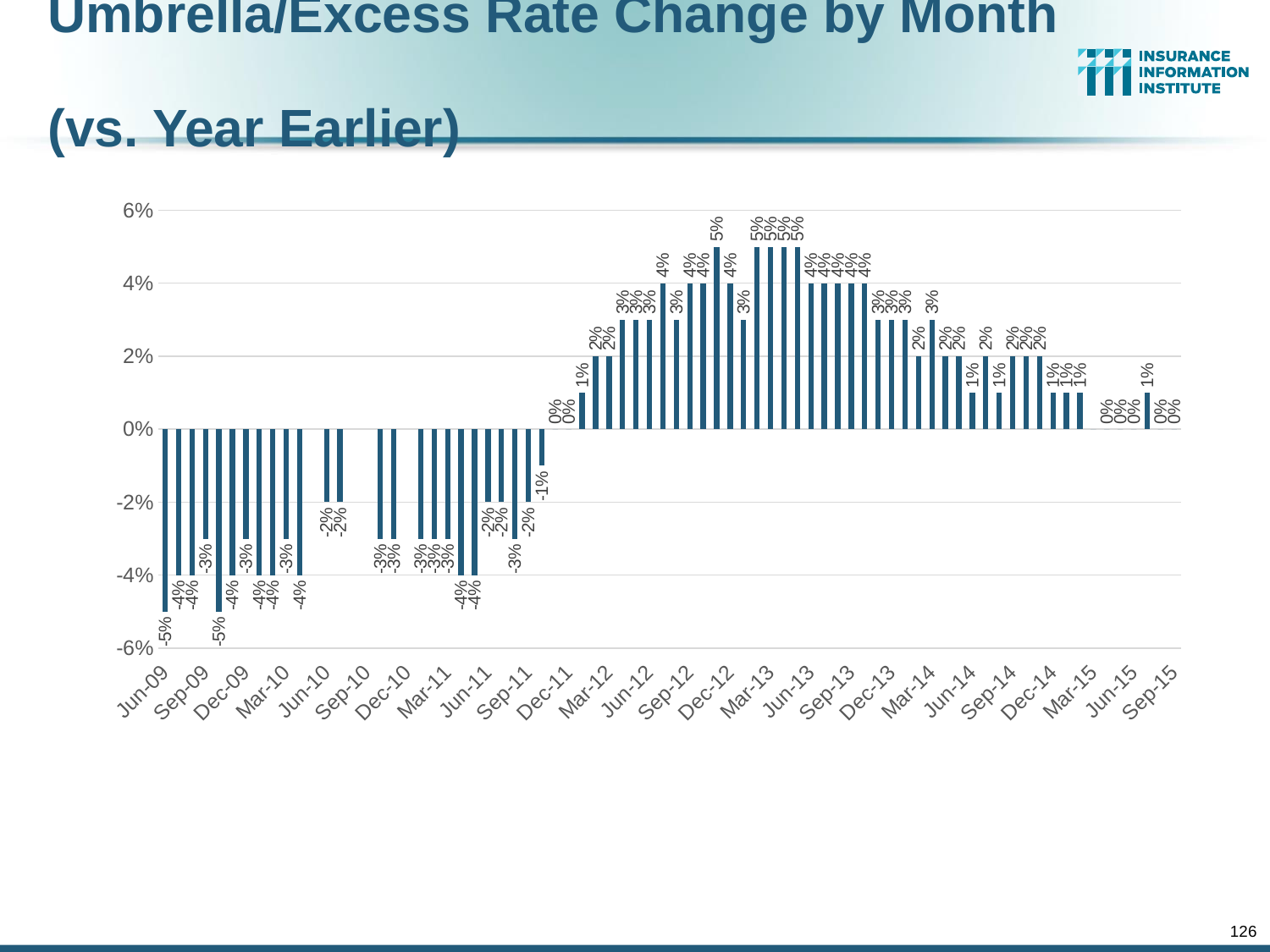
Which is larger, the value for Jun-09 or the value for Sep-15? Sep-15 What is the difference between the highest value (5%) and the lowest value (-5%) on the chart? 10% What is the highest rate change value shown on the chart? 5% What are the minimum and maximum values shown on the vertical axis? -6% and 6% How many data series are plotted on the chart? 1 What is the title of the chart on the slide? Umbrella/Excess Rate Change by Month (vs. Year Earlier) Is the value for Jun-09 greater or less than -4%? less What is the lowest rate change value shown on the chart? -5% What is the umbrella/excess rate change for Sep-15, the last bar on the chart? 0% What is the umbrella/excess rate change for Jun-09, the first bar on the chart? -5% Do the rate changes generally rise or fall from Jun-09 to early 2013? rise What kind of chart is shown on the slide? bar chart